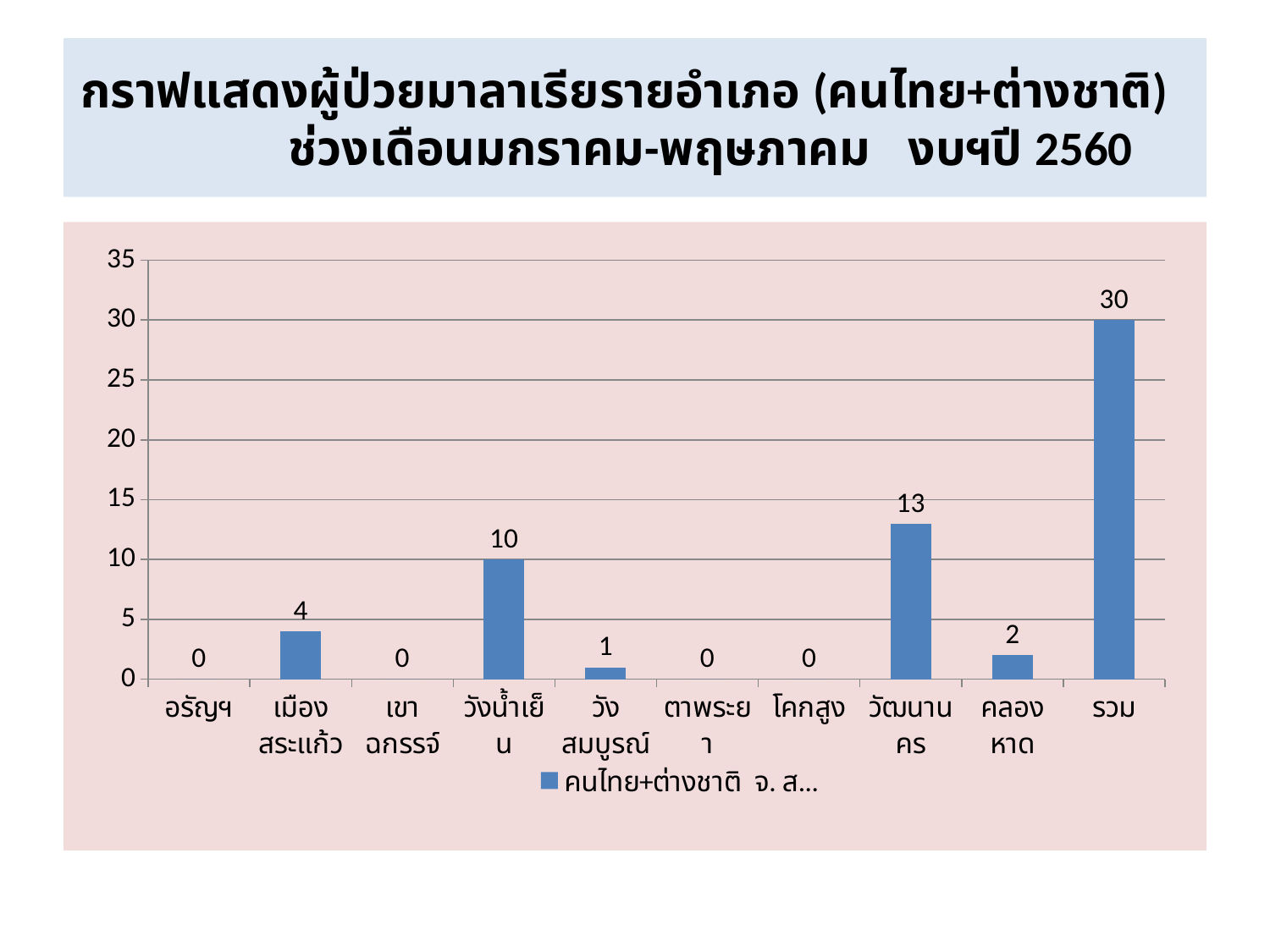
What is the value for เมืองสระแก้ว? 4 What is the value for คลองหาด? 2 How many series does the legend list? 1 What is the value for วัฒนานคร? 13 How many categories have a value of 0? 4 Excluding the รวม bar, which district has the highest value? วัฒนานคร What is the value for วังน้ำเย็น? 10 What is the value shown for รวม? 30 What kind of chart is shown on the slide? Bar chart How many categories are shown on the x axis? 10 What is the difference between the values for วัฒนานคร and วังน้ำเย็น? 3 Which is larger, the value for เมืองสระแก้ว or the value for คลองหาด? เมืองสระแก้ว